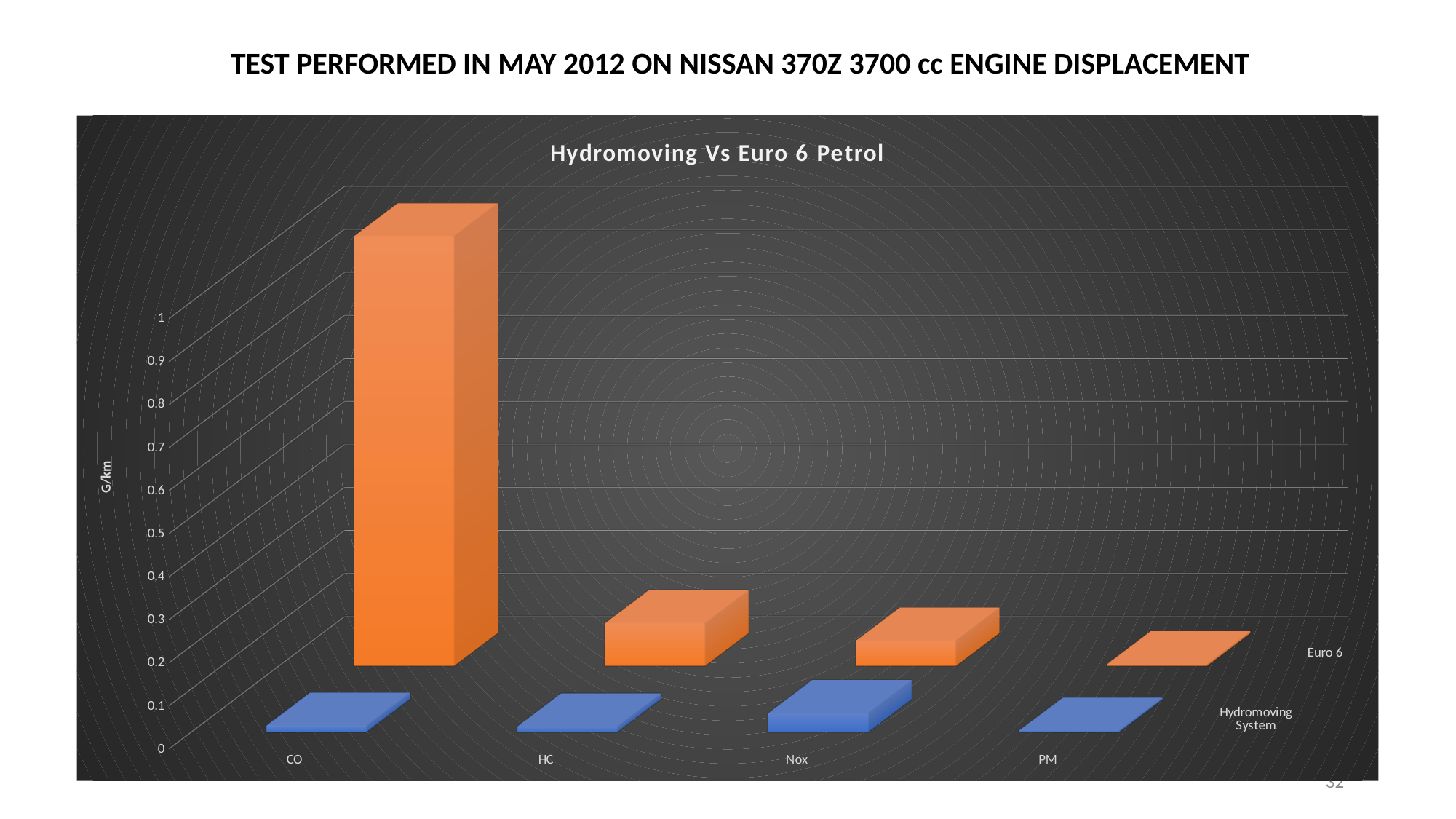
What unit is shown on the vertical axis label? G/km For the Euro 6 series, which category has the lowest value? PM What is the title of the chart? Hydromoving Vs Euro 6 Petrol Is the Euro 6 value for HC greater or less than 0.5? less Is the Hydromoving System value for CO greater or less than 0.2? less For CO, which series has the larger value, Euro 6 or Hydromoving System? Euro 6 What kind of chart is shown on the slide? bar chart For the Euro 6 series, which is larger, the value for CO or the value for HC? CO For the Euro 6 series, which category has the highest value? CO Is the Euro 6 value for CO greater or less than 0.5? greater How many pollutant categories are shown on the x axis? 4